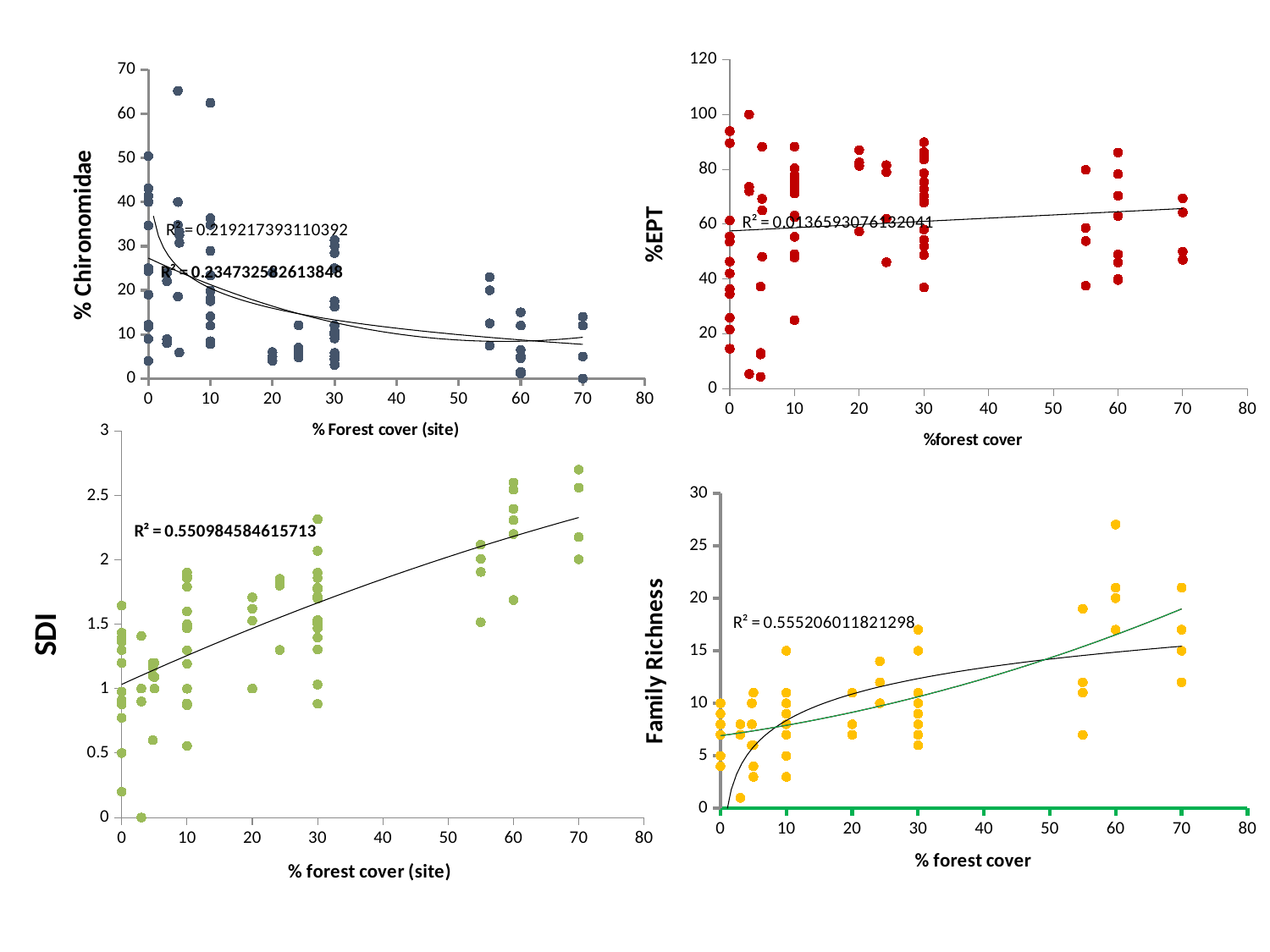
In the bottom-left SDI chart, what R² value is printed on the chart? 0.550984584615713 In the top-left % Chironomidae chart, do the fitted trend lines rise or fall as % Forest cover increases? fall In the top-right %EPT chart, what R² value is printed on the chart? 0.0136593076132041 What is the y-axis label of the top-right chart? %EPT What kind of chart is the top-left chart showing % Chironomidae against % Forest cover (site)? scatter chart In the top-left % Chironomidae chart, is the highest point near 5% forest cover greater or less than 60? greater In the bottom-right Family Richness chart, what R² value is printed on the chart? 0.555206011821298 How many charts are shown on the slide? 4 In the bottom-right Family Richness chart, is the highest point at 60% forest cover greater or less than 25? greater What is the highest value shown on the y-axis of the top-right %EPT chart? 120 In the bottom-left SDI chart, does the fitted trend line rise or fall as % forest cover increases? rise In the bottom-left SDI chart, which has the higher maximum SDI value: 0% forest cover or 70% forest cover? 70% forest cover